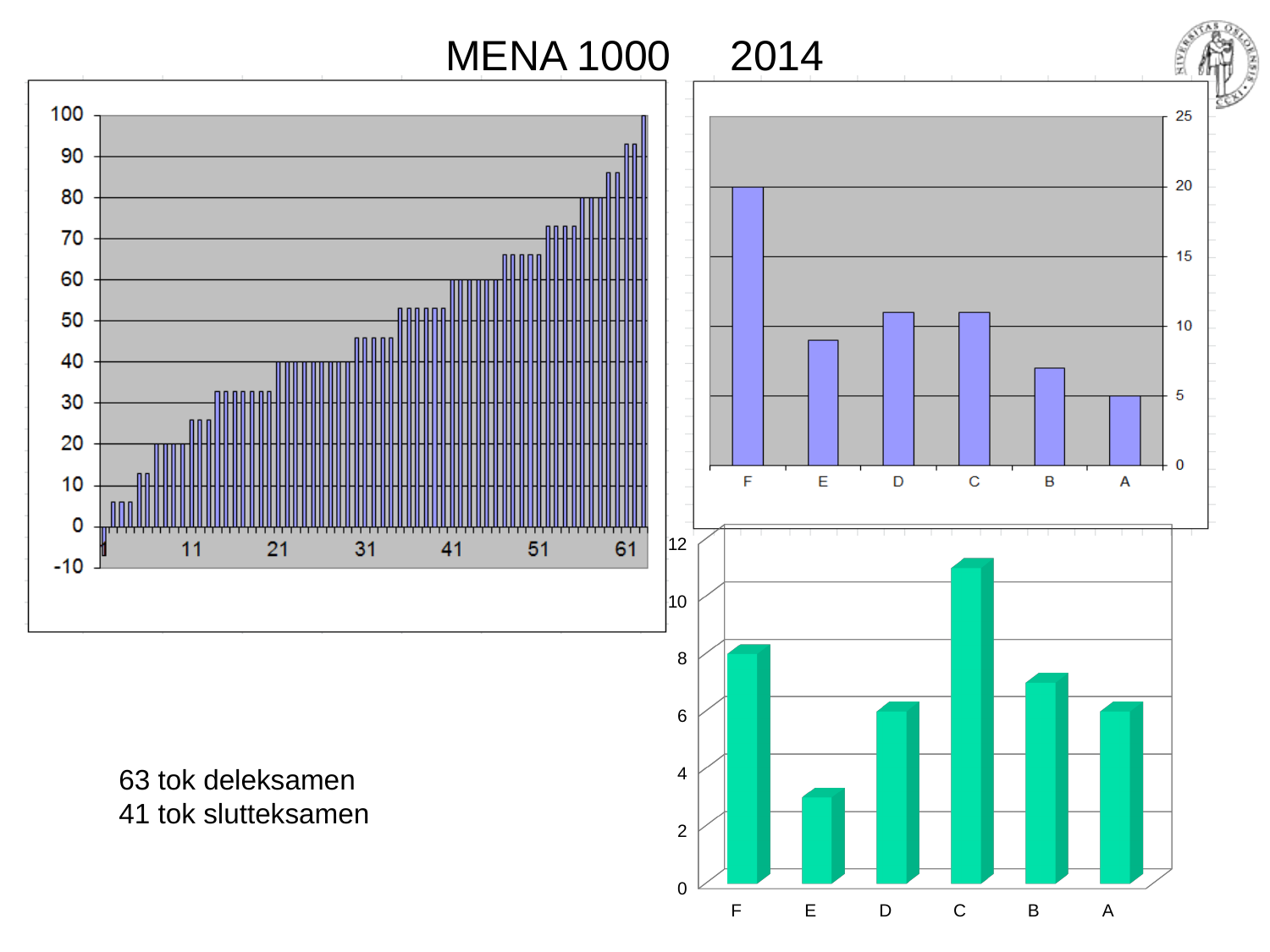
What kind of chart is the top-right chart with categories F to A? bar chart In the top-right chart, what is the value for F? 20 In the top-right chart, what is the value for A? 5 In the top-right chart, which is larger, the value for D or the value for B? D In the top-right chart, is the value for E greater or less than 10? less In the bottom-right chart, what is the value for F? 8 In the bottom-right chart, which category has the lowest value? E In the top-right chart, which category has the lowest value? A In the top-right chart, which category has the highest value? F In the bottom-right chart, is the value for C greater or less than 10? greater How many categories are shown in the top-right chart? 6 In the bottom-right chart, which category has the highest value? C